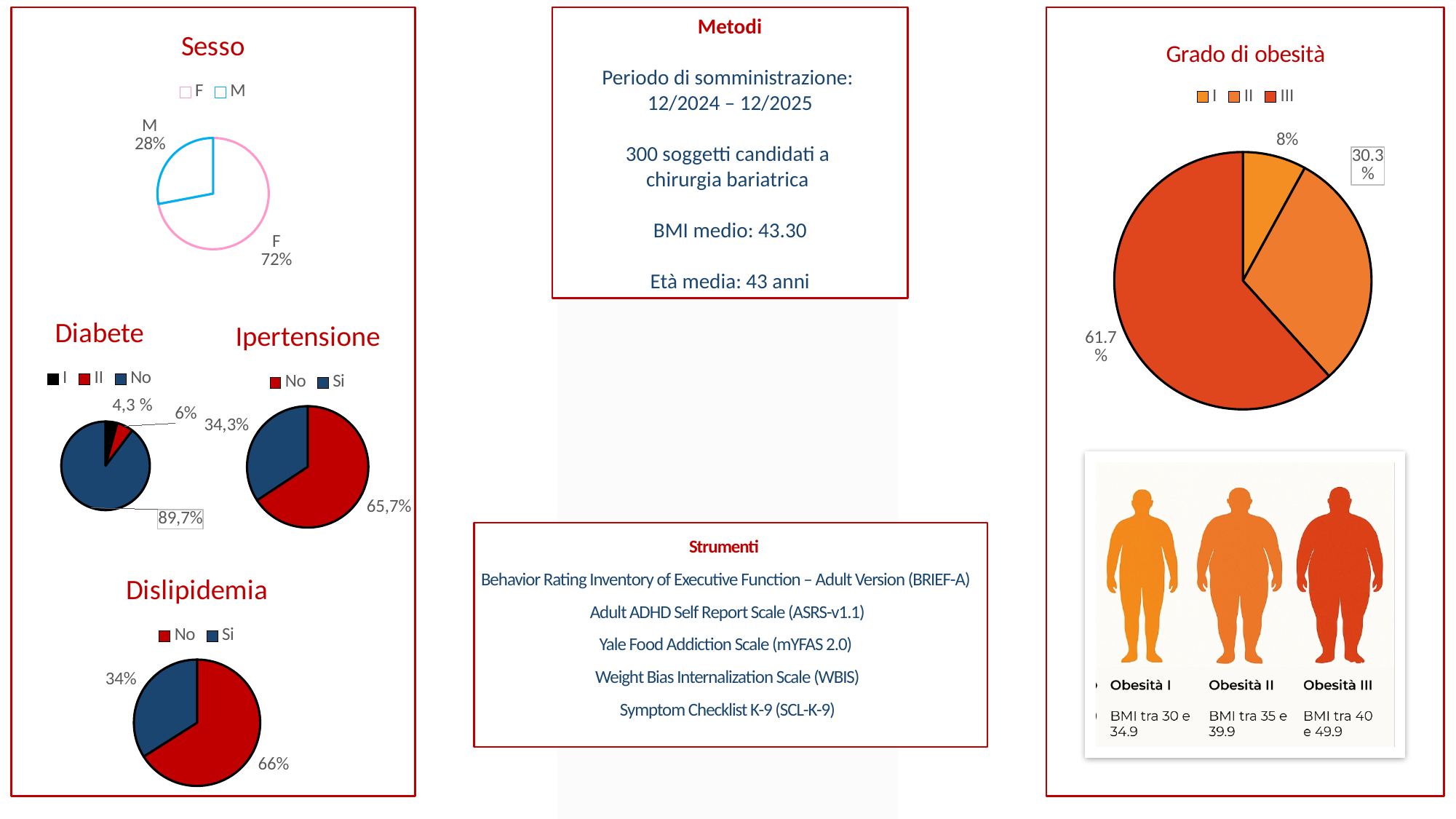
In the 'Dislipidemia' pie chart, what percentage is shown for 'Si'? 34% In the 'Sesso' pie chart, what percentage is shown for M? 28% In the 'Diabete' pie chart, which category has the largest slice? No In the 'Sesso' pie chart, what is the difference between the F and M shares? 44% In the 'Grado di obesità' pie chart, what percentage is shown for grade III? 61.7% In the 'Ipertensione' pie chart, what percentage is shown for 'No'? 65,7% In the 'Sesso' pie chart, what percentage is shown for F? 72% How many series does the legend of the 'Grado di obesità' chart list? 3 In the 'Grado di obesità' pie chart, which grade has the smallest slice? I In the 'Ipertensione' pie chart, what percentage is shown for 'Si'? 34,3% In the 'Diabete' pie chart, what percentage is shown for 'No'? 89,7% In the 'Dislipidemia' pie chart, which is larger, 'No' or 'Si'? No